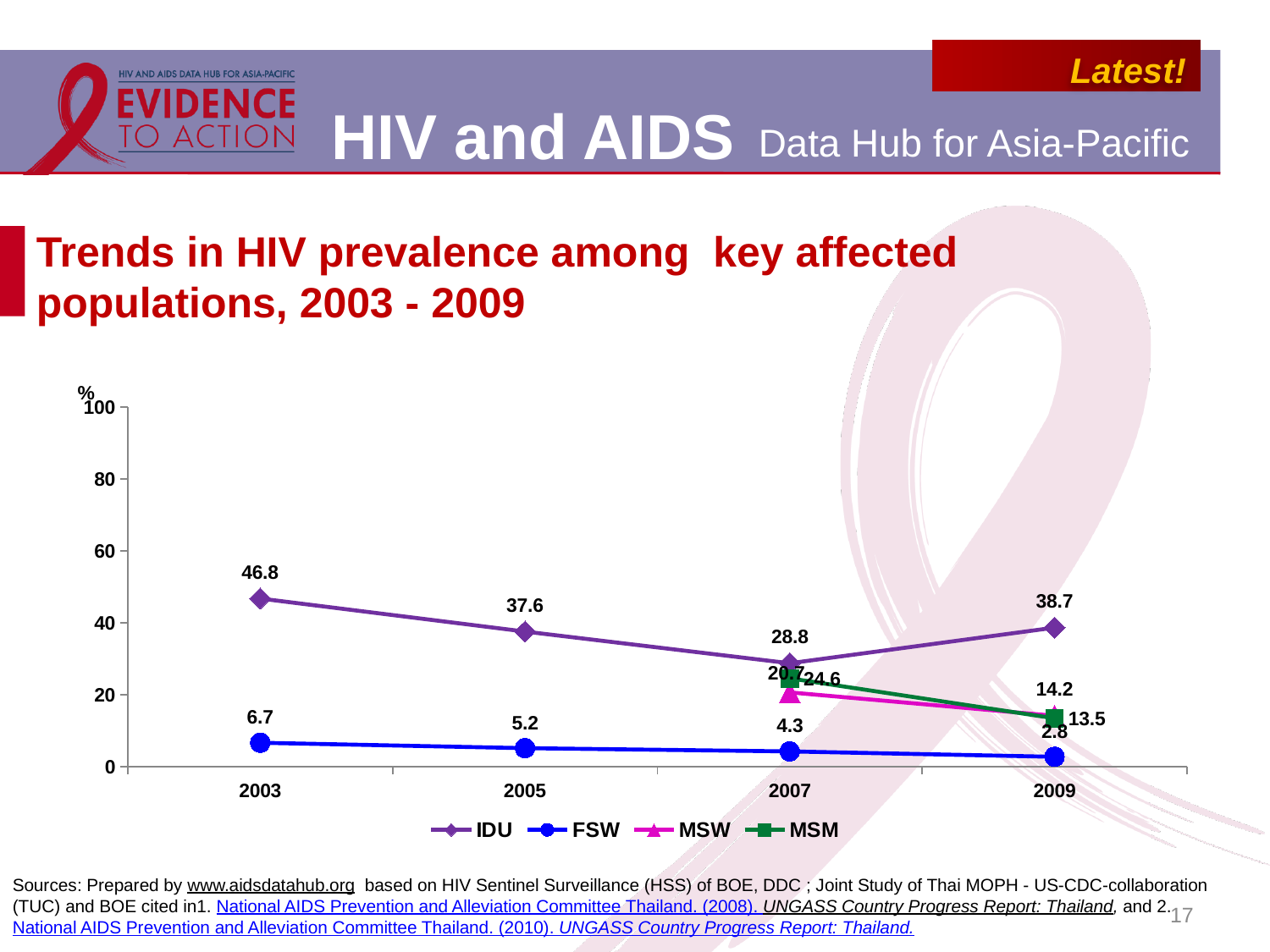
How many years are shown on the x axis? 4 How many series does the legend list? 4 What is the HIV prevalence value for IDU in 2003? 46.8 What kind of chart is shown on the slide? line chart What is the value for IDU in 2007? 28.8 Is the IDU value for 2003 greater or less than 40? greater What is the difference between the IDU values in 2003 and 2005? 9.2 What is the value for FSW in 2009? 2.8 In which year is the FSW value lowest? 2009 In which year is the IDU value highest? 2003 Does the FSW series rise or fall from 2003 to 2009? fall Which series has the larger value in 2009, IDU or FSW? IDU